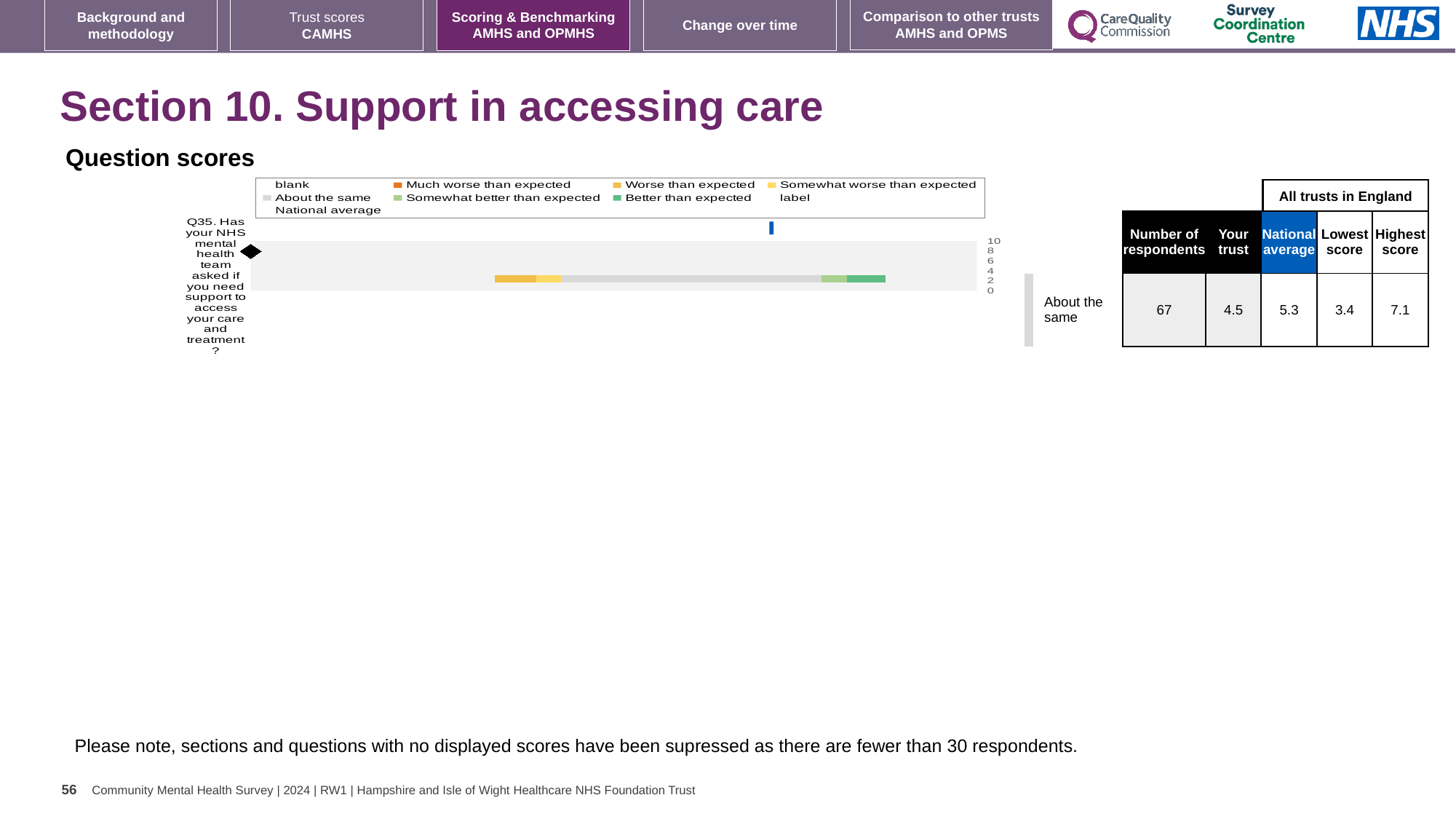
What is the lowest score among all trusts in England for Q35? 3.4 Which question number is plotted in the Question scores chart? Q35 What is the highest tick value shown on the score axis of the Question scores chart? 10 How many respondents answered Q35? 67 What kind of chart is used to show the Q35 question score? bar chart How many questions are plotted in the Question scores chart? 1 How many entries does the legend of the Question scores chart list? 9 What is the difference between the highest score and the lowest score for Q35? 3.7 For Q35, which is larger: the 'Your trust' score or the national average? National average What is the highest score among all trusts in England for Q35? 7.1 What is the national average score for Q35? 5.3 What is the 'Your trust' score for Q35? 4.5